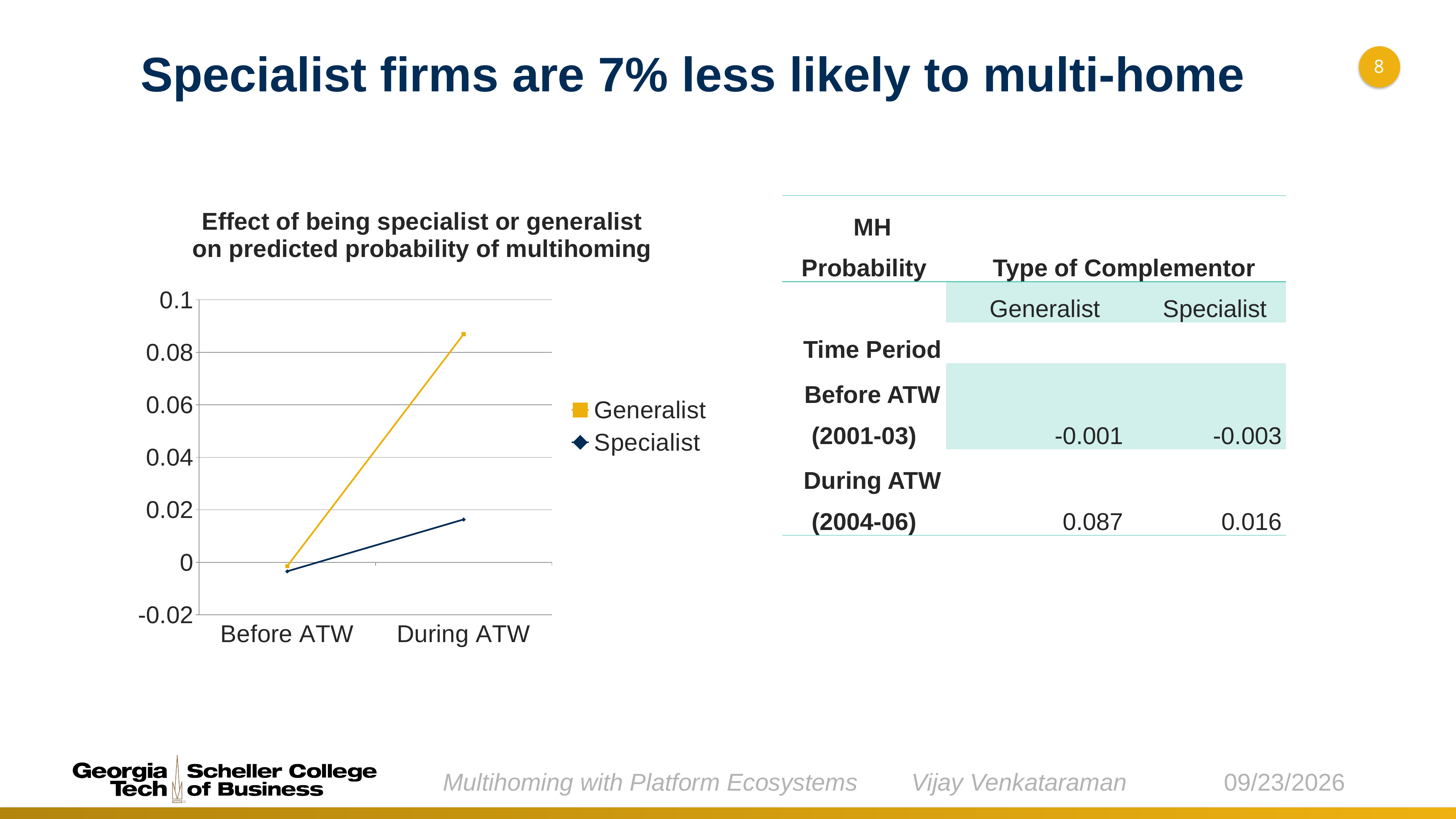
What is the value for Generalist during ATW? 0.087 Which series has the higher value during ATW? Generalist Does the Generalist series rise or fall from Before ATW to During ATW? rise How many categories are shown on the x axis of the chart? 2 Which series is drawn in yellow in the chart? Generalist How many series does the chart legend list? 2 Is the value for Generalist during ATW greater or less than 0.08? greater What is the value for Specialist before ATW? -0.003 What is the difference between the Generalist and Specialist values during ATW? 0.071 What kind of chart is shown on the slide? line chart What is the title of the chart? Effect of being specialist or generalist on predicted probability of multihoming What is the value for Specialist during ATW? 0.016